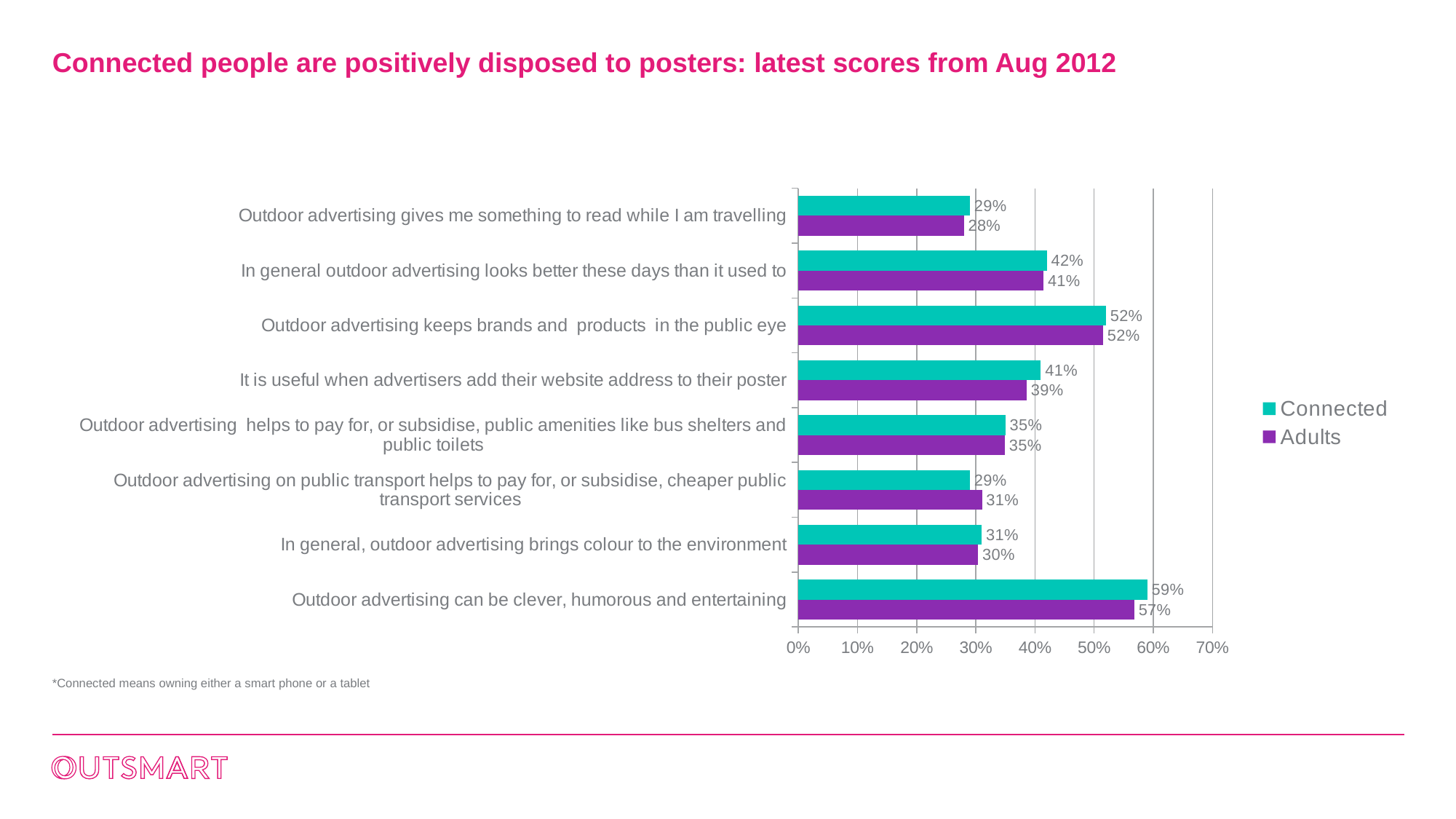
Which colour represents the Adults series in the legend? Purple What is the Adults value for "It is useful when advertisers add their website address to their poster"? 39% Is the Connected value for "Outdoor advertising keeps brands and products in the public eye" greater or less than 50%? greater How many series does the legend list? 2 What is the Adults value for "Outdoor advertising gives me something to read while I am travelling"? 28% What is the difference between the Connected and Adults values for "Outdoor advertising can be clever, humorous and entertaining"? 2% What kind of chart is shown on the slide? Bar chart How many statements (categories) are shown on the chart? 8 Which statement has the lowest Adults value? Outdoor advertising gives me something to read while I am travelling What is the Connected value for "Outdoor advertising can be clever, humorous and entertaining"? 59% Which statement has the highest Connected value? Outdoor advertising can be clever, humorous and entertaining For "Outdoor advertising on public transport helps to pay for, or subsidise, cheaper public transport services", which is larger: the Connected value or the Adults value? Adults